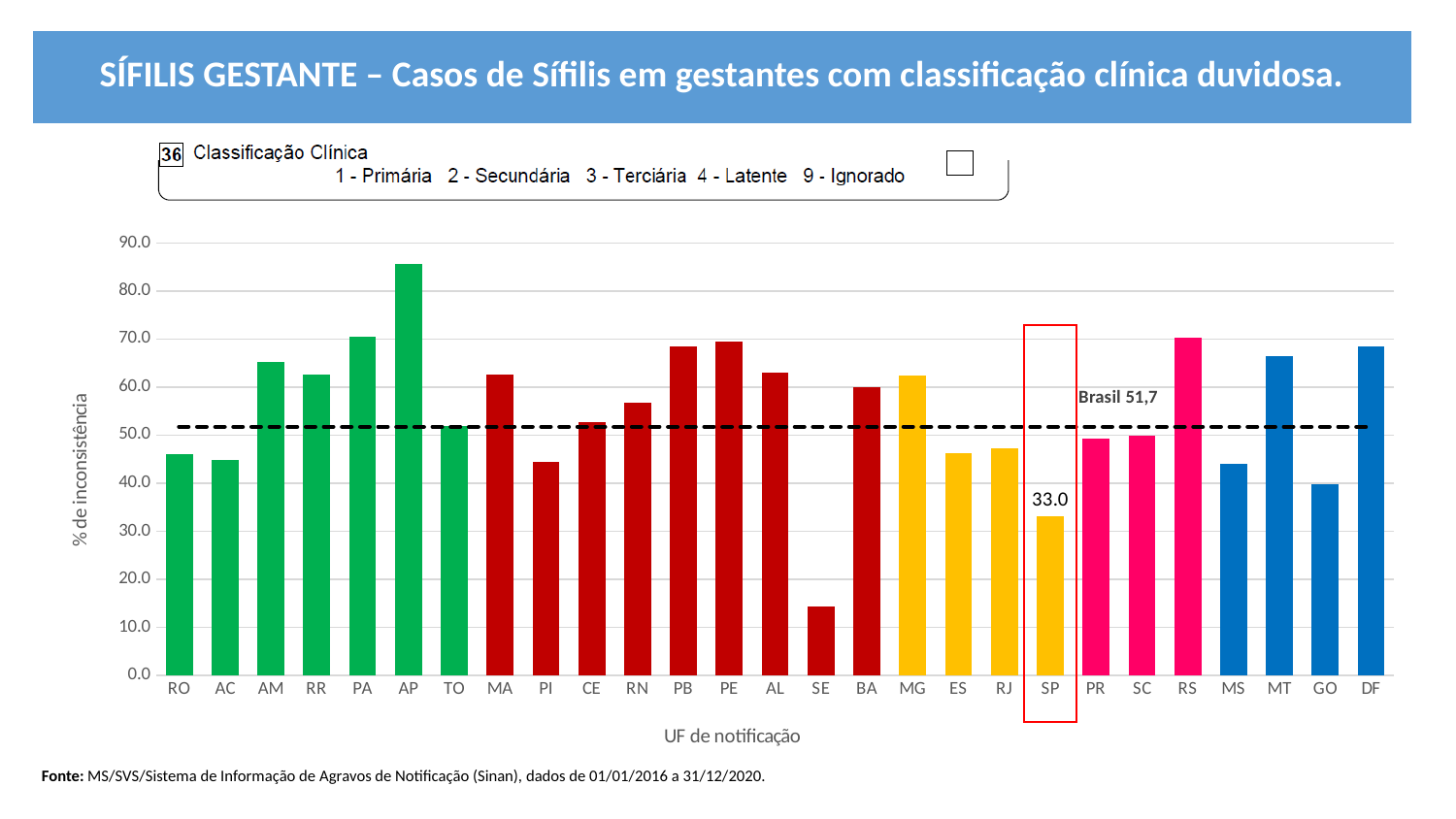
What is the value shown for SP? 33.0 Is the value for SE greater or less than 20? less Which UF has the lowest % de inconsistência? SE What value does the dashed horizontal line labelled Brasil represent? 51,7 What type of chart is shown on the slide? bar chart Is the value for DF greater or less than 60? greater What is the label of the x axis? UF de notificação Is the value for PI greater or less than 50? less How many UFs (categories) are plotted on the x axis? 27 Which has the larger value, PB or PI? PB Which UF has the highest % de inconsistência? AP